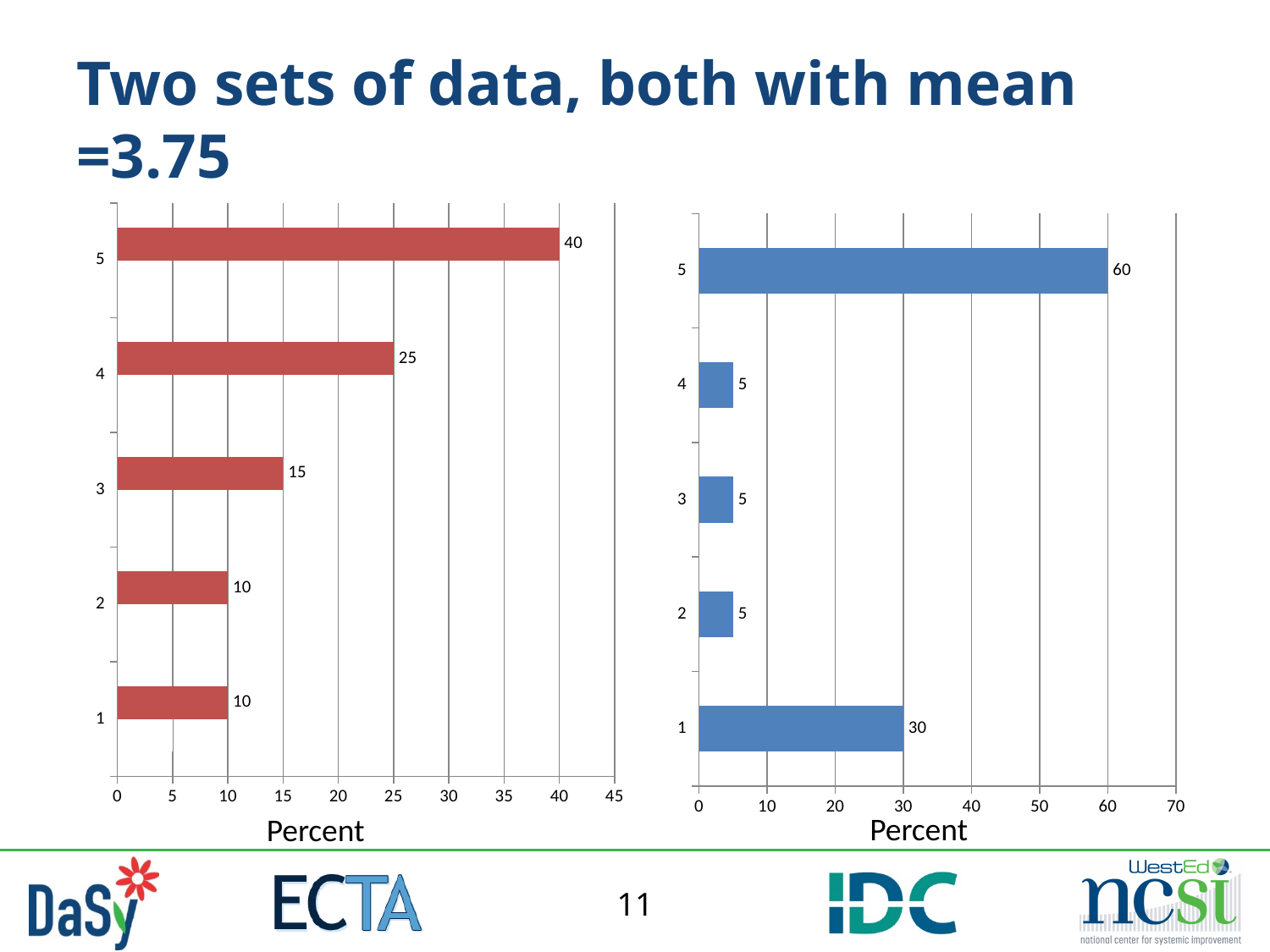
In the right chart, what is the difference between the values for category 5 and category 1? 30 What kind of chart is the left chart? Bar chart In the left chart, is the value for category 4 larger than the value for category 2? Yes How many categories are shown in the right chart? 5 What is the x-axis label on the right chart? Percent In the left chart, what is the difference between the values for category 5 and category 4? 15 In the right chart, what is the value for category 1? 30 What is the maximum value shown on the x axis of the right chart? 70 In the left chart, which category has the lowest value, 3 or 4? 3 In the right chart, which category has the highest value? 5 In the left chart, what is the value for category 5? 40 In the left chart, what is the value for category 3? 15